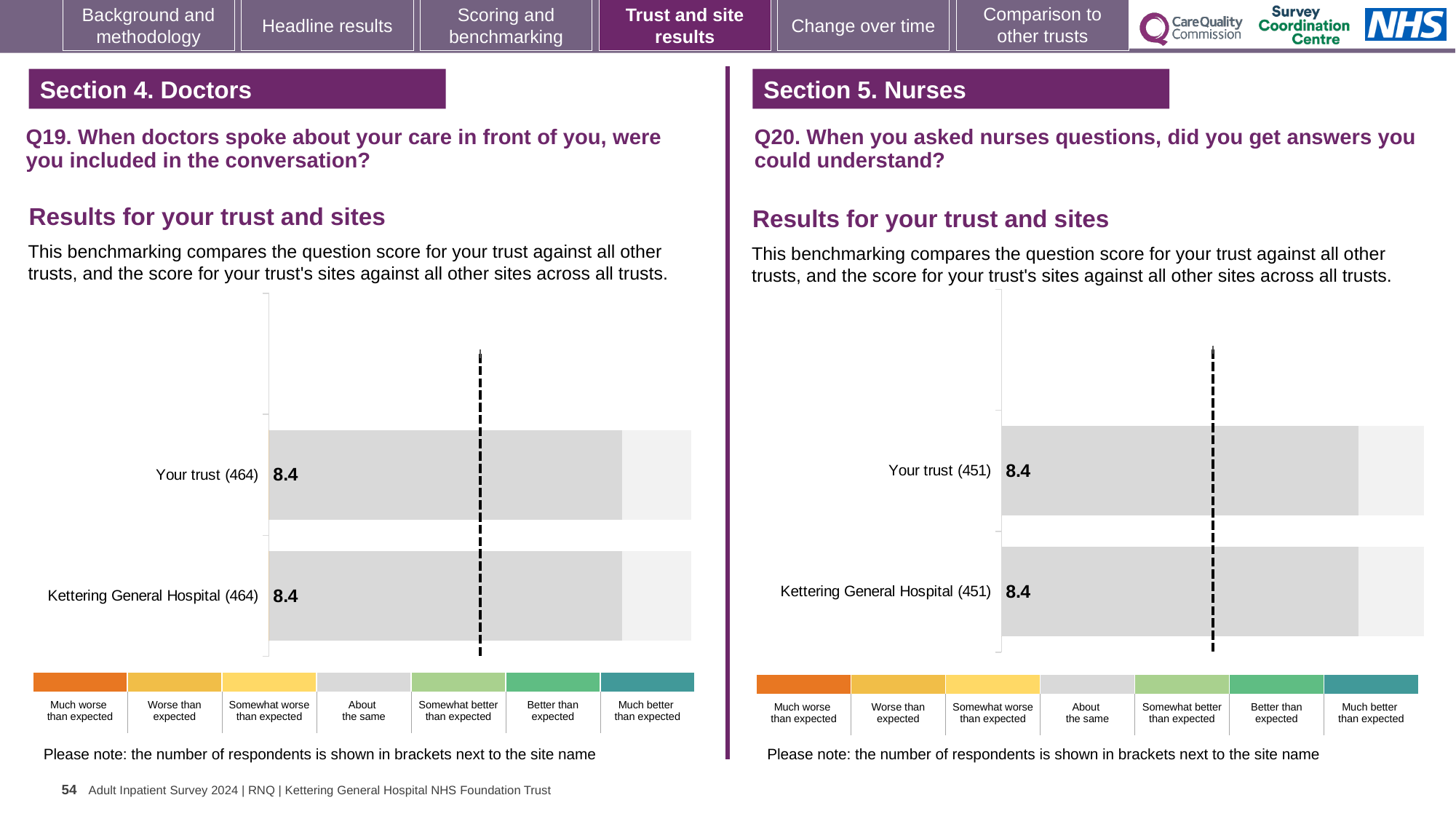
In the Q19 chart on the left, what is the difference between the score for Your trust and the score for Kettering General Hospital? 0 In the Q20 chart on the right, what is the score for Your trust? 8.4 In the Q20 chart on the right, what is the difference between the score for Your trust and the score for Kettering General Hospital? 0 What kind of chart is the Q19 chart on the left? Bar chart In the Q20 chart on the right, what is the score for Kettering General Hospital? 8.4 In the Q19 chart on the left, what is the score for Your trust? 8.4 In the Q20 chart on the right, how many bars are plotted? 2 In the Q19 chart on the left, how many bars are plotted? 2 In the Q20 chart on the right, how many respondents are shown in brackets next to Kettering General Hospital? 451 In the Q19 chart on the left, what is the score for Kettering General Hospital? 8.4 In the Q19 chart on the left, how many respondents are shown in brackets next to Your trust? 464